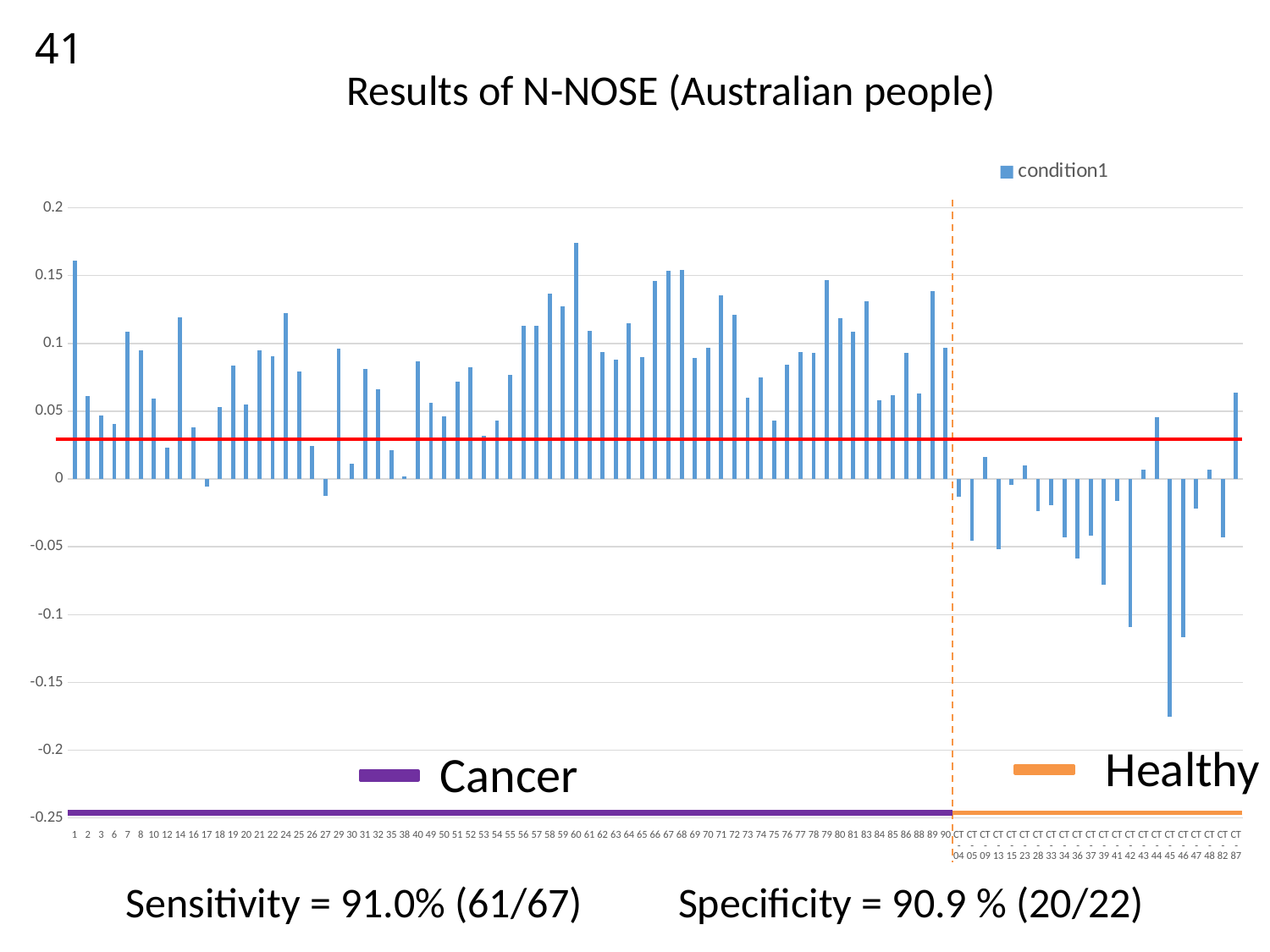
What is the name of the series shown in the legend? condition1 Is the value for sample 24 greater or less than 0.1? greater Which sample has the lowest value in the chart? CT-45 Is the value for sample 27 greater or less than 0? less Which has the larger value, sample 1 or sample 2? sample 1 Is the value for sample CT-45 greater or less than -0.15? less How many series does the chart legend list? 1 Which has the larger value, sample 60 or sample 79? sample 60 What kind of chart is shown on the slide? bar chart Which sample has the highest value in the chart? 60 What is the title of the chart? Results of N-NOSE (Australian people)